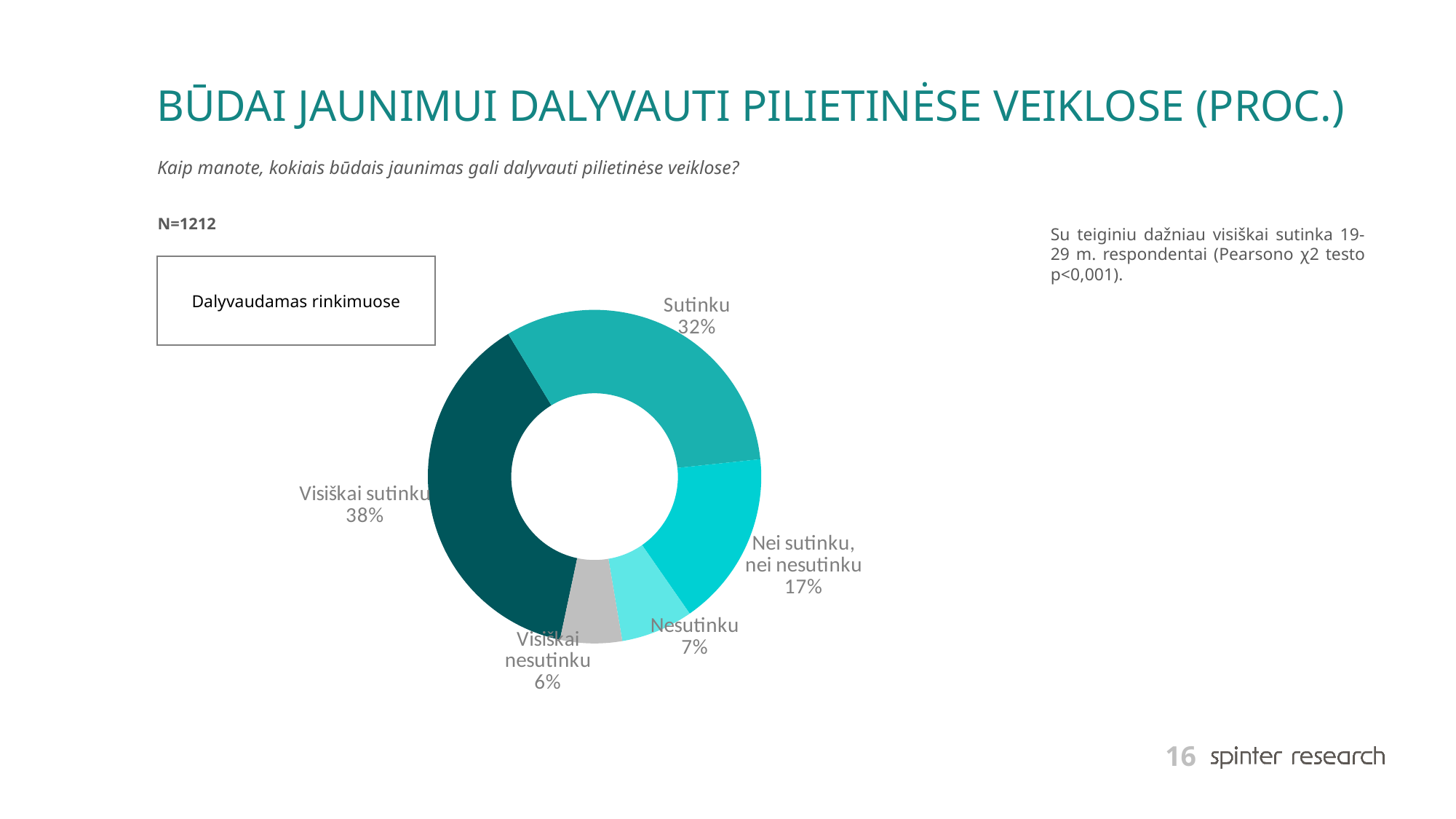
What is the difference in percentage points between "Visiškai sutinku" and "Sutinku"? 6 What percentage of respondents answered "Nesutinku"? 7% What percentage of respondents answered "Visiškai nesutinku"? 6% Which response category has the largest share of the chart? Visiškai sutinku What percentage of respondents answered "Nei sutinku, nei nesutinku"? 17% What statement does the chart refer to, as shown in the box to the left of the chart? Dalyvaudamas rinkimuose What percentage of respondents answered "Visiškai sutinku"? 38% What percentage of respondents answered "Sutinku"? 32% What kind of chart is shown on the slide? Pie chart (doughnut) How many response categories are shown in the chart? 5 Which response category has the smallest share of the chart? Visiškai nesutinku Which is larger: the share for "Nei sutinku, nei nesutinku" or the share for "Nesutinku"? Nei sutinku, nei nesutinku